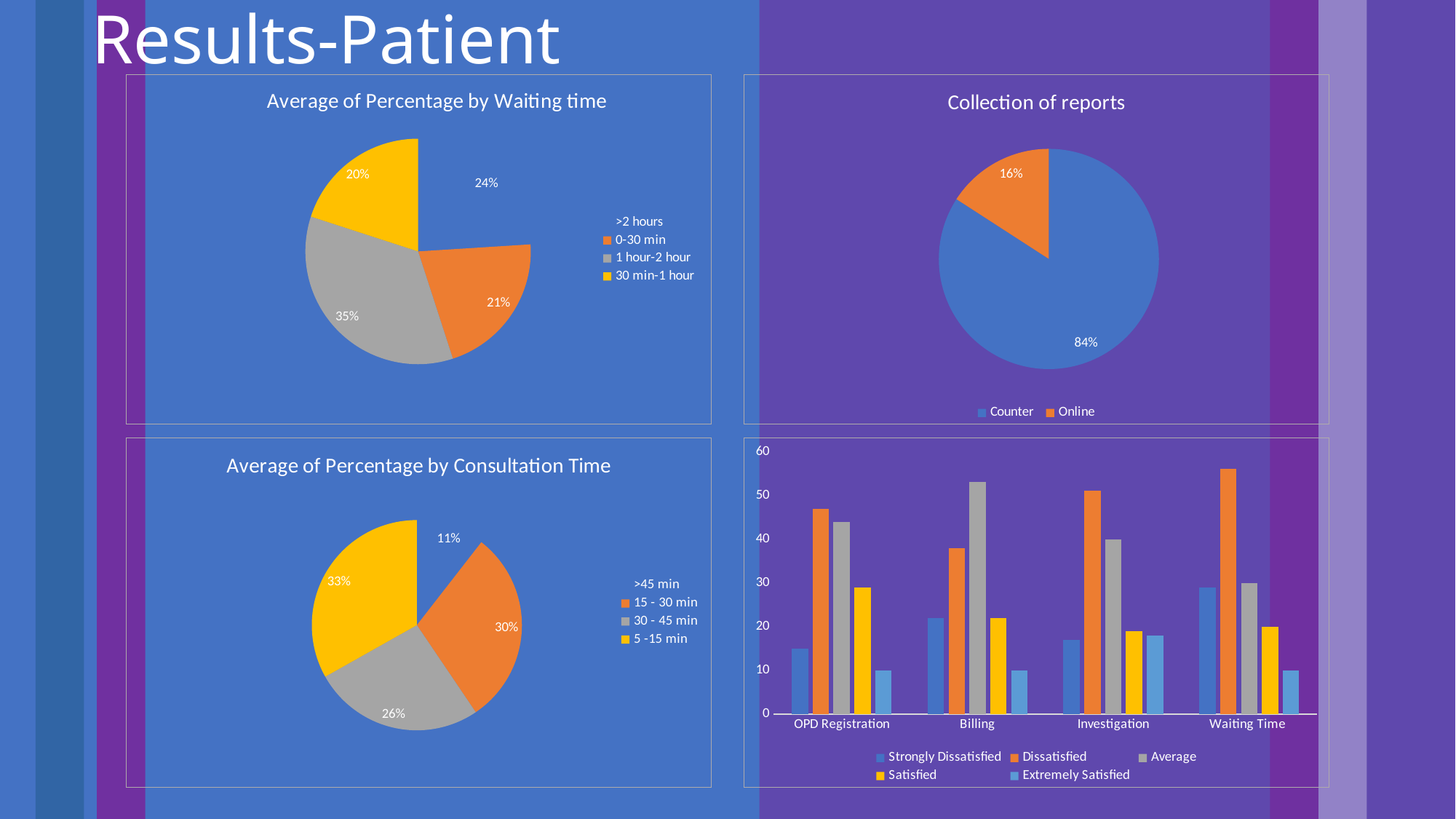
In the 'Collection of reports' pie chart, what percentage of reports were collected online? 16% In the 'Average of Percentage by Consultation Time' pie chart, what percentage is shown for the 5 -15 min slice? 33% In the 'Collection of reports' pie chart, how many categories does the legend list? 2 In the 'Average of Percentage by Consultation Time' pie chart, which is larger: the 15 - 30 min share or the 30 - 45 min share? 15 - 30 min In the bar chart at the bottom right, how many series does the legend list? 5 In the 'Average of Percentage by Waiting time' pie chart, which waiting time category has the largest share? 1 hour-2 hour In the 'Average of Percentage by Consultation Time' pie chart, which consultation time category has the smallest share? >45 min In the bar chart at the bottom right, is the Dissatisfied value for Waiting Time greater or less than 50? greater In the 'Average of Percentage by Waiting time' pie chart, what is the difference between the 0-30 min share and the 30 min-1 hour share? 1% In the 'Average of Percentage by Waiting time' pie chart, what percentage is shown for the 1 hour-2 hour slice? 35% In the bar chart at the bottom right, which series has the highest bar for Billing? Average What kind of chart is the untitled chart at the bottom right of the slide? Bar chart